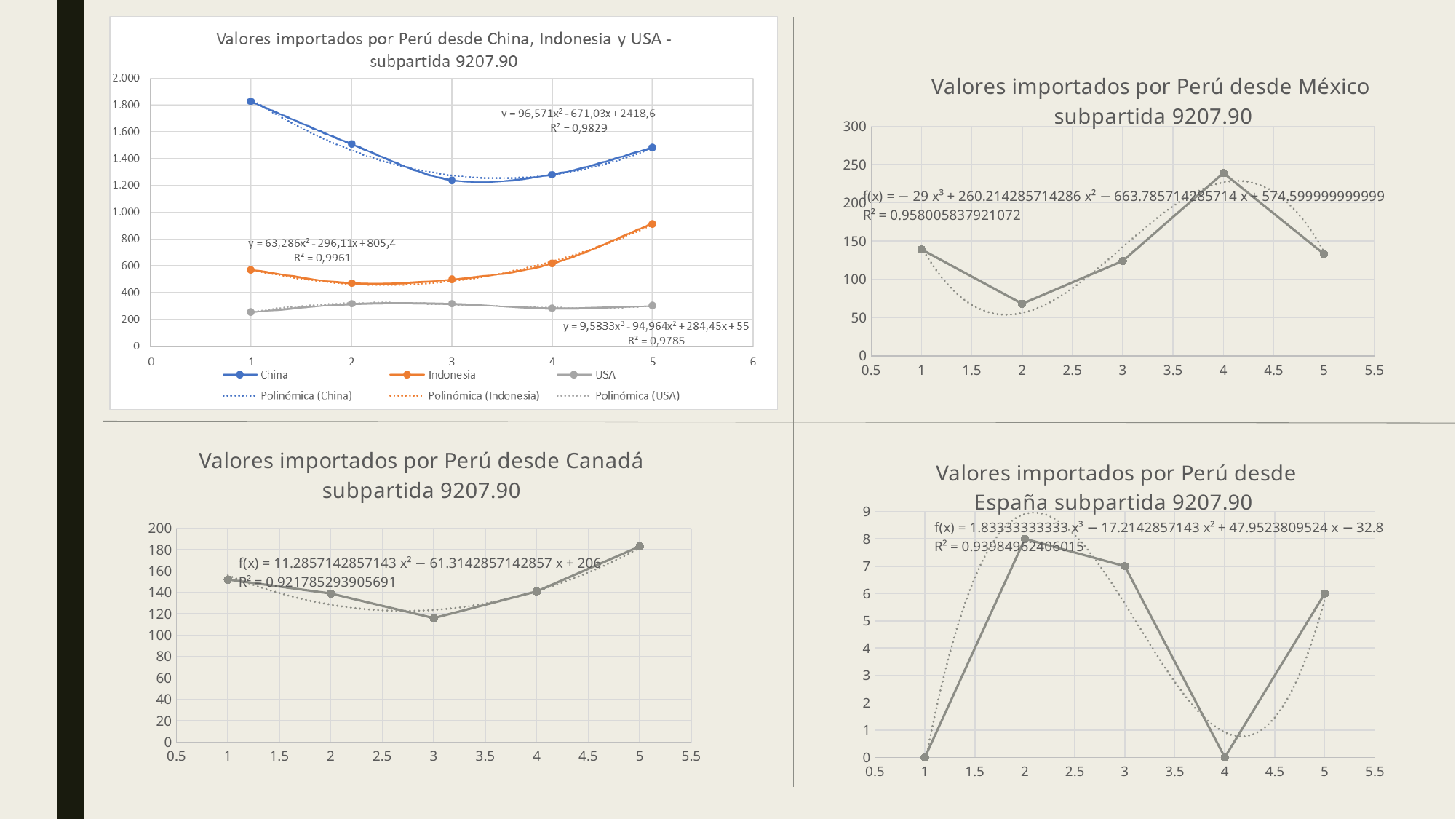
In the chart titled "Valores importados por Perú desde España subpartida 9207.90", what is the value at x = 4? 0 In the chart titled "Valores importados por Perú desde México subpartida 9207.90", at which x value is the lowest point? 2 In the chart titled "Valores importados por Perú desde China, Indonesia y USA - subpartida 9207.90", is the value for China at x = 1 greater or less than 1.600? greater In the chart titled "Valores importados por Perú desde México subpartida 9207.90", at which x value is the highest point? 4 In the chart titled "Valores importados por Perú desde Canadá subpartida 9207.90", at which x value is the lowest point? 3 In the chart titled "Valores importados por Perú desde China, Indonesia y USA - subpartida 9207.90", what colour is the Indonesia line? Orange In the chart titled "Valores importados por Perú desde Canadá subpartida 9207.90", is the value at x = 5 greater or less than 160? greater What type of chart is the chart titled "Valores importados por Perú desde España subpartida 9207.90"? Line chart In the chart titled "Valores importados por Perú desde China, Indonesia y USA - subpartida 9207.90", how many entries does the legend list? 6 In the chart titled "Valores importados por Perú desde China, Indonesia y USA - subpartida 9207.90", is the value for Indonesia at x = 5 greater or less than 800? greater In the chart titled "Valores importados por Perú desde China, Indonesia y USA - subpartida 9207.90", which series has the highest values across all points? China